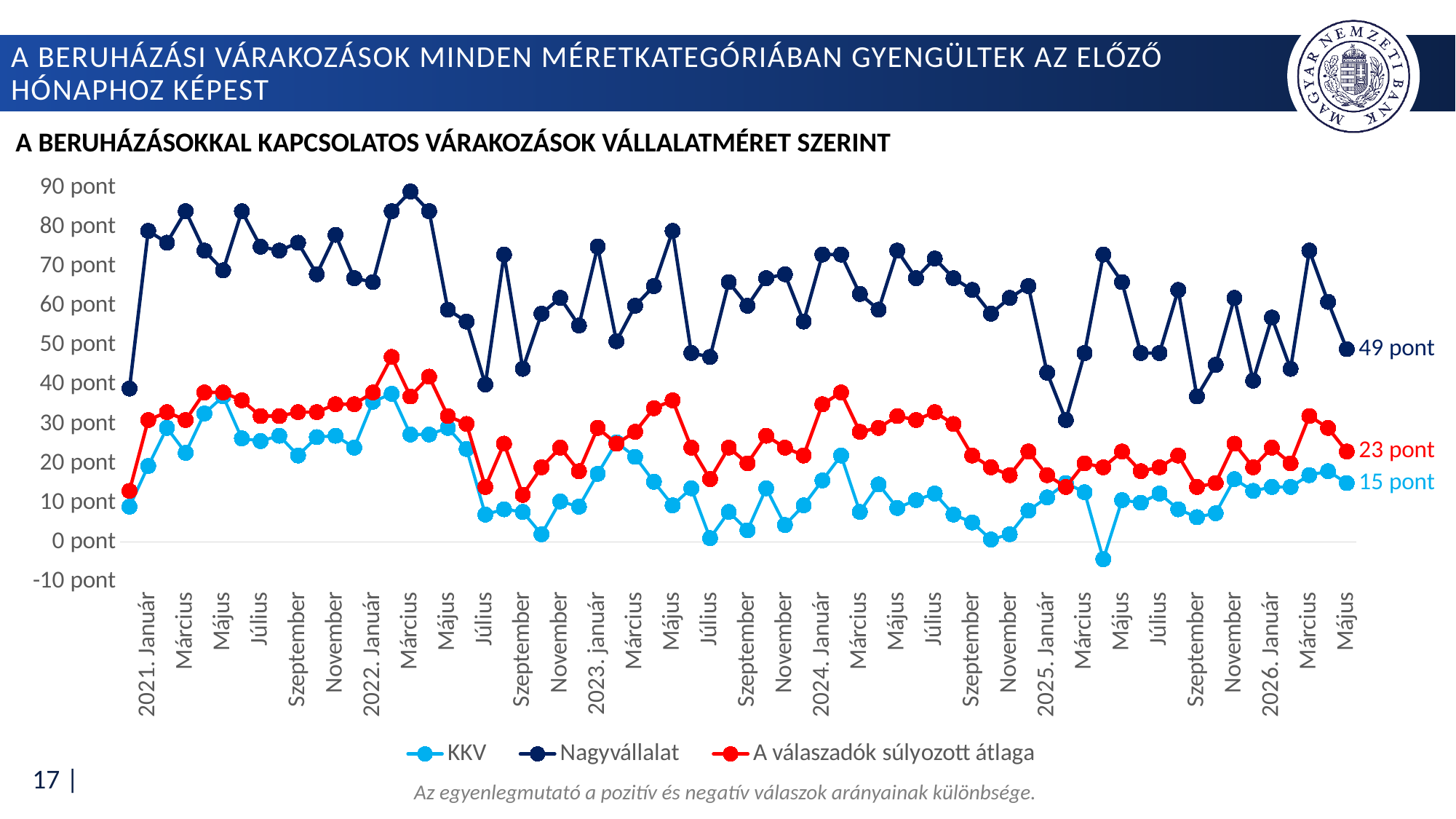
What is the title of the chart? A beruházásokkal kapcsolatos várakozások vállalatméret szerint Which series has the lowest value at the end of the chart (2026 Május)? KKV What is the latest value shown for the 'A válaszadók súlyozott átlaga' series? 23 pont Is the KKV value for 2025 Május greater or less than 0 pont? greater Is the Nagyvállalat value for 2021. Január greater or less than 50 pont? greater What kind of chart is shown on the slide? Line chart Is the final value of the Nagyvállalat series larger or smaller than the final value of the weighted average series? Larger What is the difference between the final Nagyvállalat value and the final KKV value? 34 pont What is the latest value shown for the KKV series? 15 pont What is the latest value shown for the Nagyvállalat series? 49 pont How many series does the legend list? 3 Which series has the highest value at the end of the chart (2026 Május)? Nagyvállalat